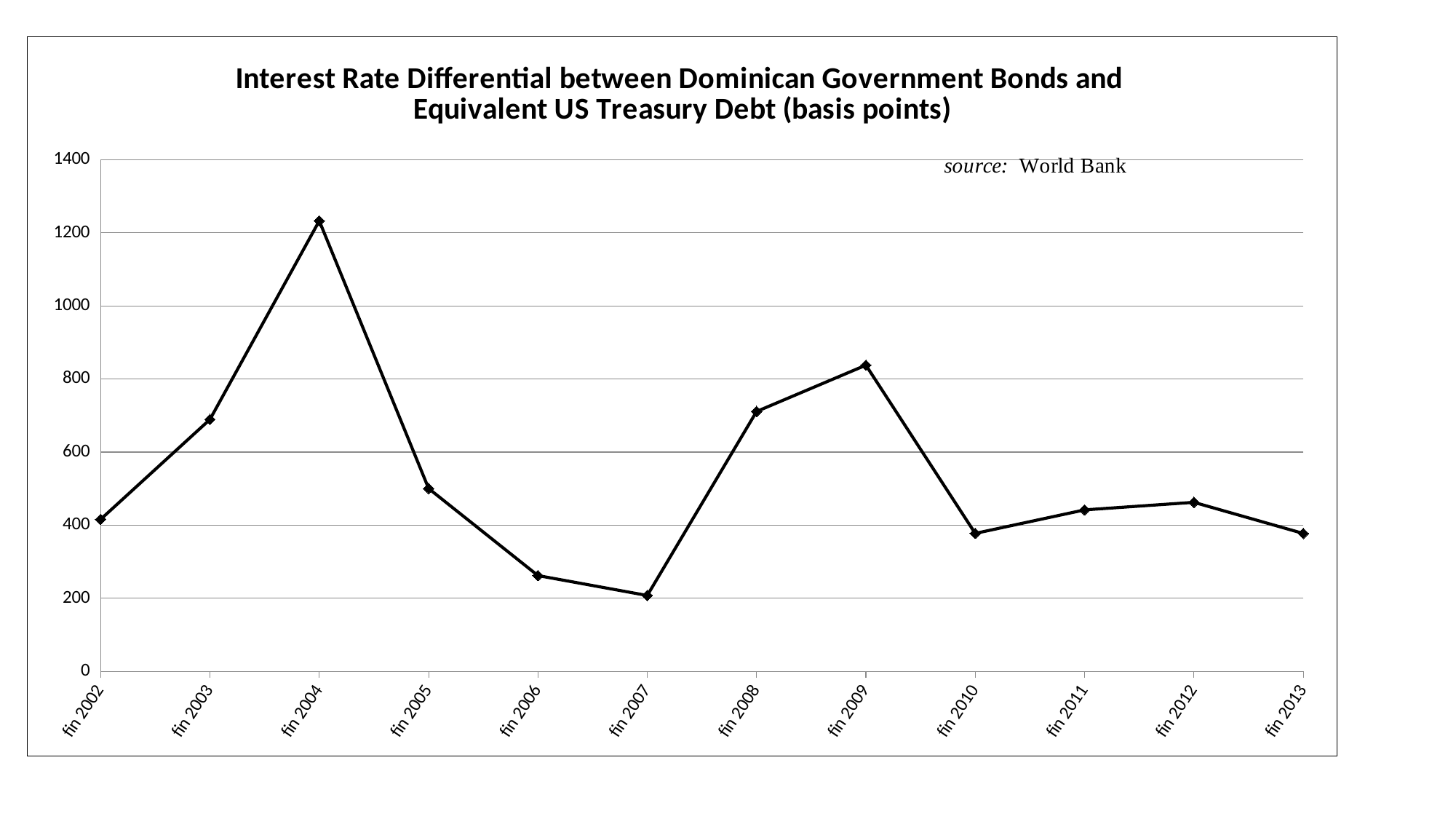
Is the value for fin 2007 greater or less than 400? less How many data points are plotted on the chart? 12 Which is larger, the value for fin 2008 or the value for fin 2009? fin 2009 Which year has the lowest interest rate differential? fin 2007 Is the value for fin 2003 greater or less than 600? greater Do the values rise or fall from fin 2004 to fin 2007? fall Which is larger, the value for fin 2003 or the value for fin 2005? fin 2003 Is the value for fin 2004 greater or less than 1000? greater What kind of chart is shown on the slide? line chart What source is cited for the chart's data? World Bank Which year has the highest interest rate differential? fin 2004